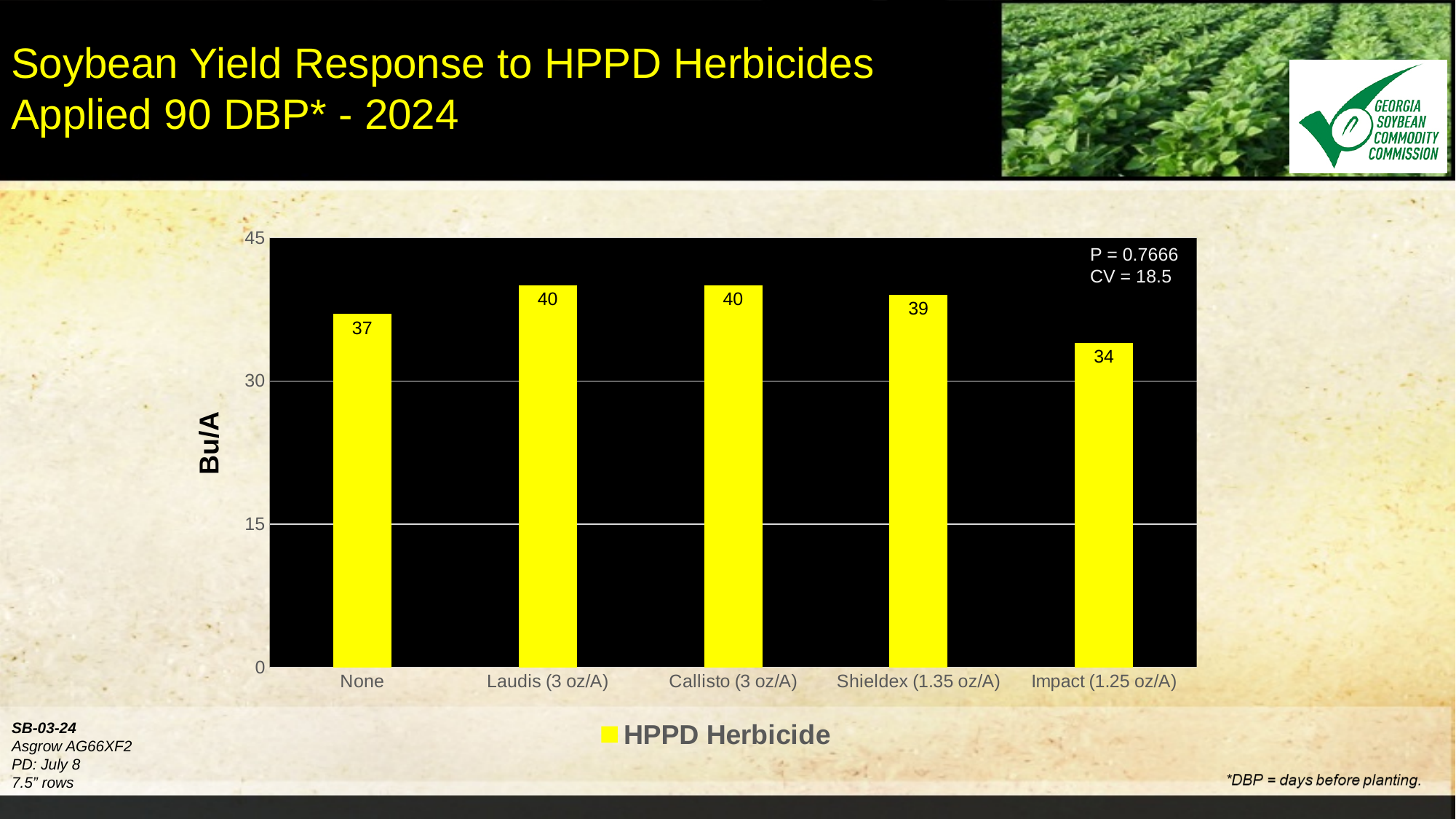
What is the yield value for Shieldex (1.35 oz/A)? 39 Is the value for Impact (1.25 oz/A) greater or less than 30? greater What is the P value shown on the chart? 0.7666 Which is larger, the yield for None or the yield for Shieldex (1.35 oz/A)? Shieldex (1.35 oz/A) What is the yield value for None? 37 Which category has the lowest yield? Impact (1.25 oz/A) How many series does the legend list? 1 How many categories are shown on the x axis? 5 What kind of chart is shown on the slide? bar chart What is the label of the y axis? Bu/A What is the yield value for Impact (1.25 oz/A)? 34 What is the difference between the yield for Laudis (3 oz/A) and the yield for Impact (1.25 oz/A)? 6